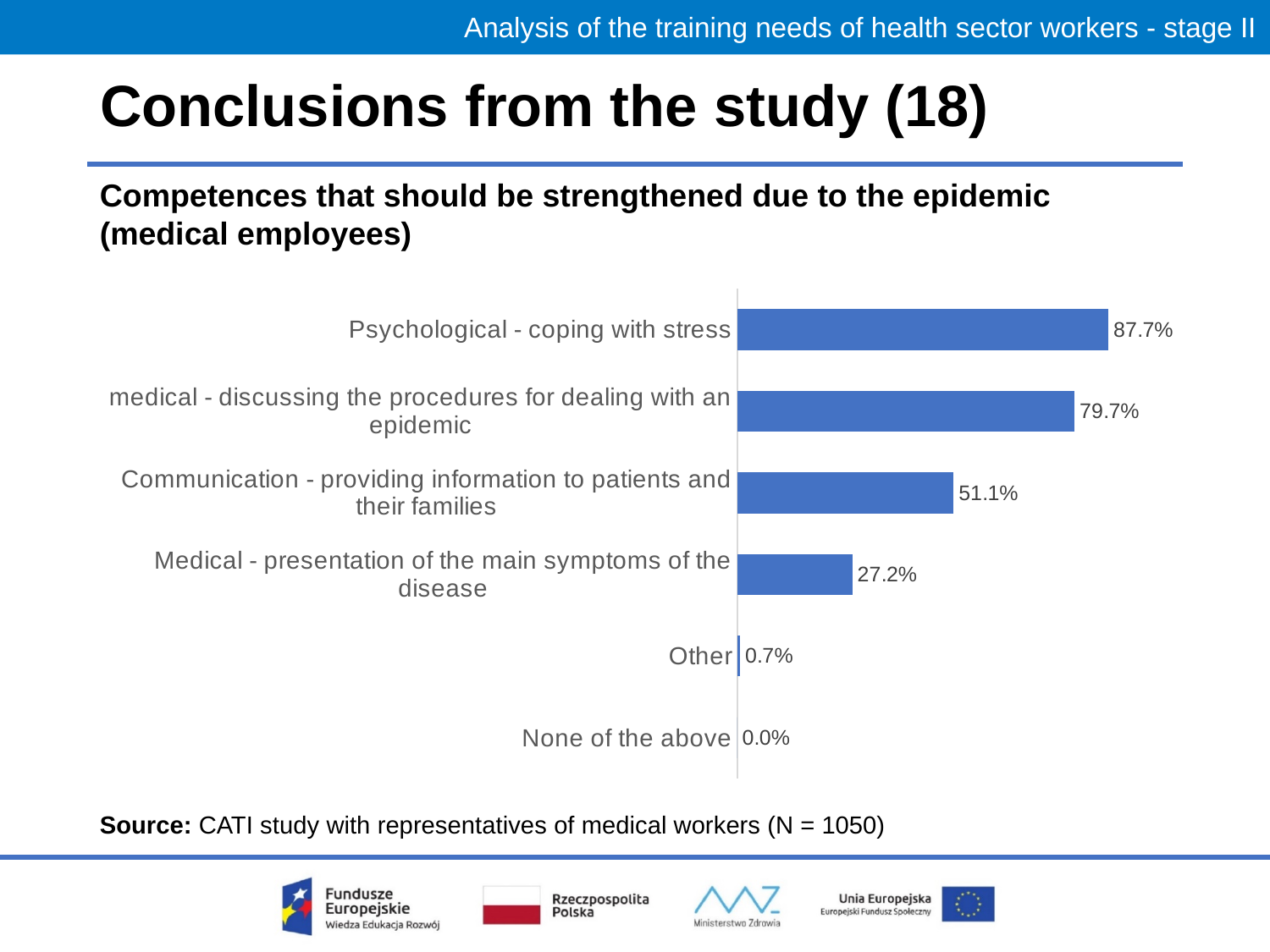
Which category has the lowest value? None of the above What is the difference between 'Psychological - coping with stress' and 'medical - discussing the procedures for dealing with an epidemic'? 8.0% What is the value for 'Communication - providing information to patients and their families'? 51.1% Which competence has the highest percentage? Psychological - coping with stress What percentage is shown for 'Psychological - coping with stress'? 87.7% How many categories are shown in the chart? 6 What percentage is shown for 'Medical - presentation of the main symptoms of the disease'? 27.2% What is the sample size (N) given in the source note below the chart? 1050 What is the value for 'Other'? 0.7% What is the difference between 'Communication - providing information to patients and their families' and 'Medical - presentation of the main symptoms of the disease'? 23.9% What type of chart is shown on the slide? Bar chart Which is larger: 'Communication - providing information to patients and their families' or 'Medical - presentation of the main symptoms of the disease'? Communication - providing information to patients and their families